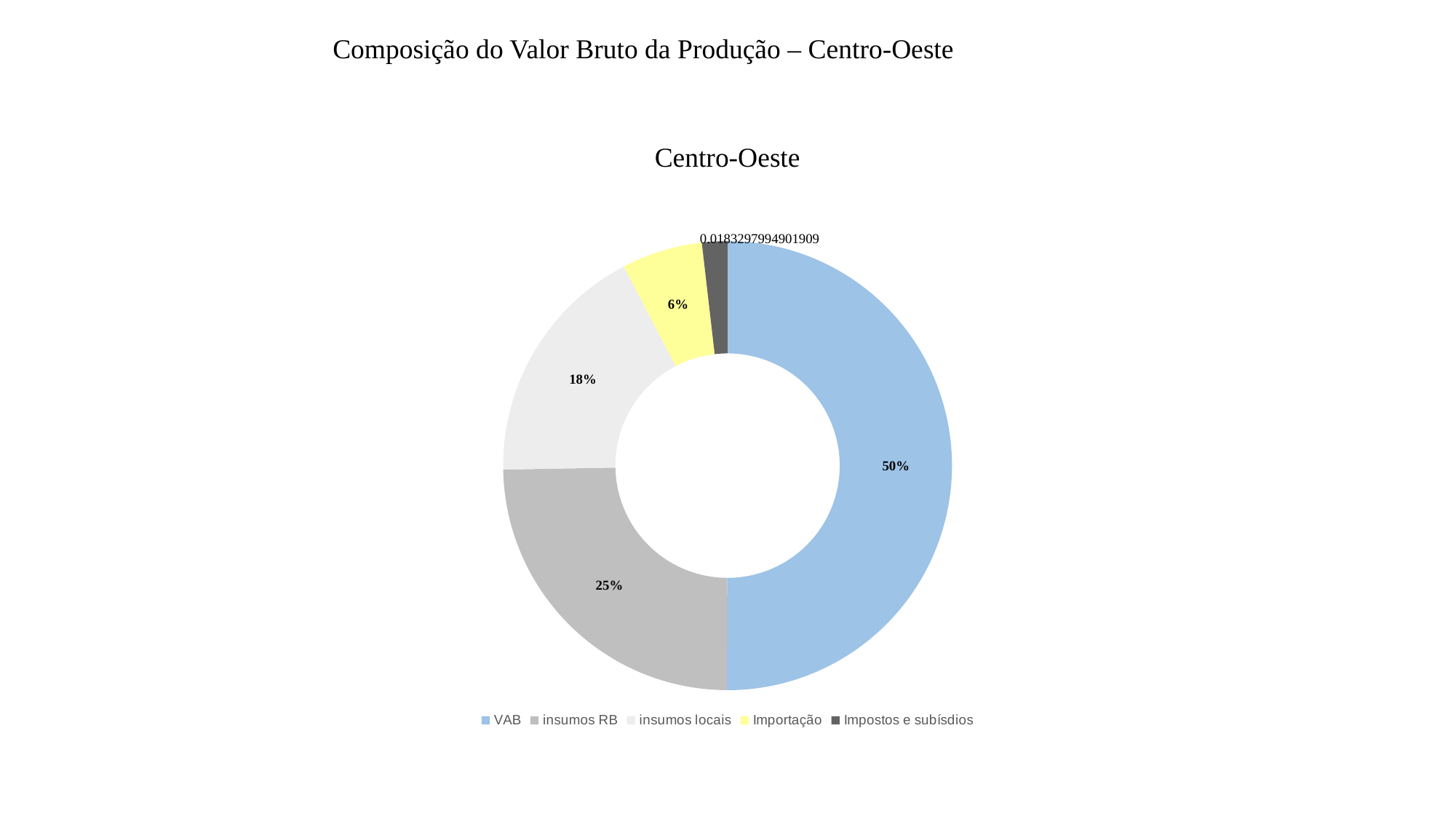
What is the value shown for Importação? 6% What is the difference between the values for VAB and insumos RB? 25% What is the value shown for insumos RB? 25% How many slices does the chart have? 5 What is the value shown for VAB? 50% Which category has the largest slice? VAB What kind of chart is shown on the slide? doughnut chart What is the value shown for insumos locais? 18% Which category has the smallest slice? Impostos e subísdios What is the title shown above the chart? Centro-Oeste What is the data label shown for Impostos e subísdios? 0.0183297994901909 Which is larger, insumos RB or insumos locais? insumos RB